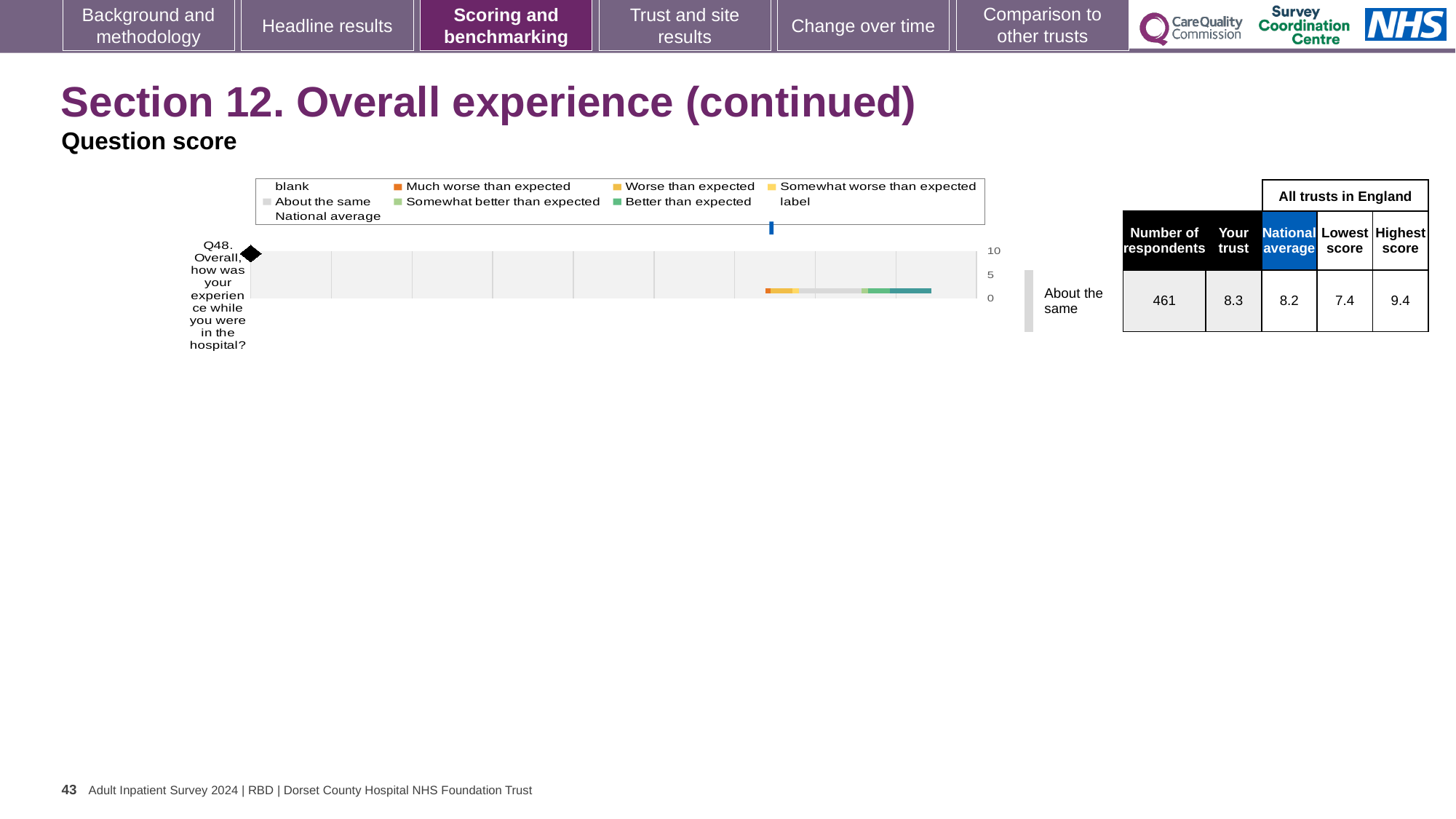
What is the national average score for Q48? 8.2 What is the 'Your trust' score for Q48? 8.3 By how much does the 'Your trust' score exceed the national average for Q48? 0.1 What is the difference between the highest score and the lowest score for Q48? 2.0 What is the highest score among all trusts in England for Q48? 9.4 Which is higher for Q48, the 'Your trust' score or the national average? Your trust What is the lowest score among all trusts in England for Q48? 7.4 What benchmark category label is shown next to the Q48 bar? About the same How many respondents answered Q48? 461 What kind of chart is shown for Q48 on the slide? bar chart Which question is plotted in the chart? Q48. Overall, how was your experience while you were in the hospital? How many questions (categories) are plotted in the chart? 1